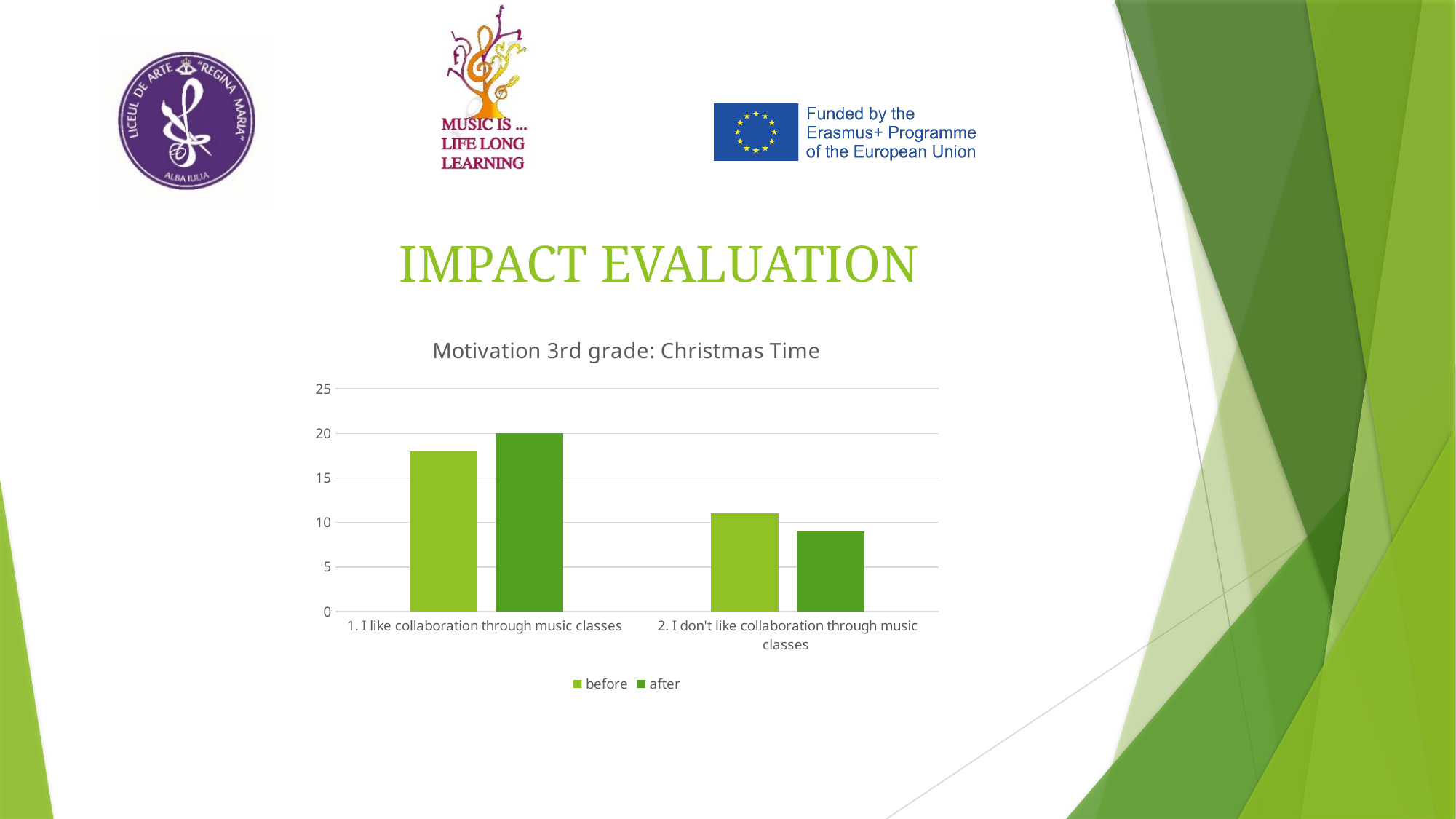
Which category has the highest 'after' value? 1. I like collaboration through music classes What is the 'after' value for '1. I like collaboration through music classes'? 20 How many categories are shown on the x axis of the chart? 2 What is the title of the chart? Motivation 3rd grade: Christmas Time Is the 'after' value for '2. I don't like collaboration through music classes' greater or less than 10? less How many series does the chart legend list? 2 What are the series names listed in the chart legend? before, after What kind of chart is shown on the slide? bar chart For '2. I don't like collaboration through music classes', which is larger, the 'before' value or the 'after' value? before Is the 'before' value for '2. I don't like collaboration through music classes' greater or less than 10? greater Which category has the lowest 'before' value? 2. I don't like collaboration through music classes Is the 'before' value for '1. I like collaboration through music classes' greater or less than 15? greater